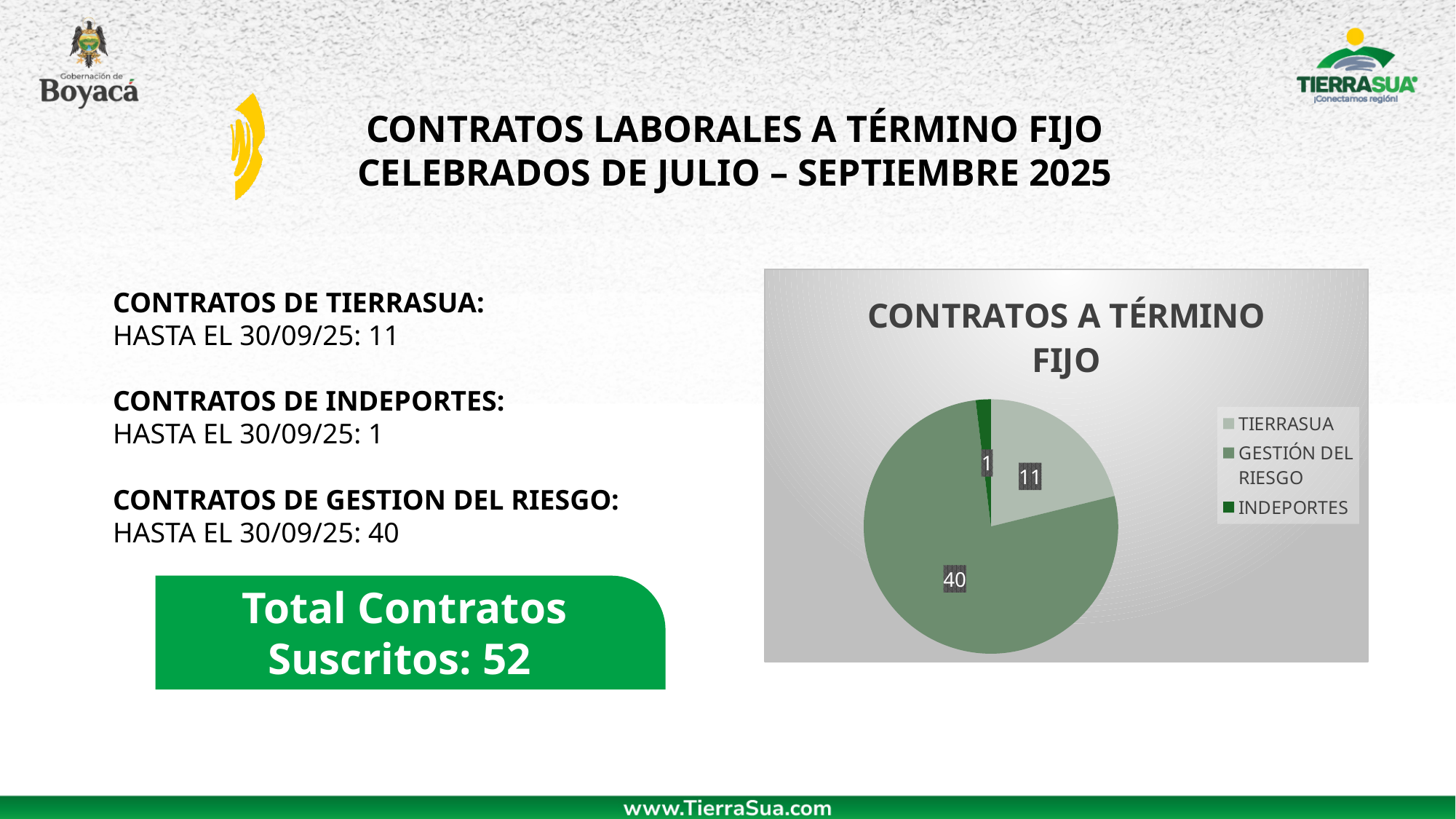
Which is larger, the value for TIERRASUA or the value for INDEPORTES? TIERRASUA What is the value for INDEPORTES in the pie chart? 1 How many slices does the pie chart have? 3 What is the title of the chart? CONTRATOS A TÉRMINO FIJO What type of chart is shown on the slide? Pie chart What is the value for TIERRASUA in the pie chart? 11 How many entries does the chart legend list? 3 What is the value for GESTIÓN DEL RIESGO in the pie chart? 40 Which category has the smallest slice in the pie chart? INDEPORTES Which category has the largest slice in the pie chart? GESTIÓN DEL RIESGO What is the total of all slices in the pie chart? 52 What is the difference between the values for GESTIÓN DEL RIESGO and TIERRASUA? 29